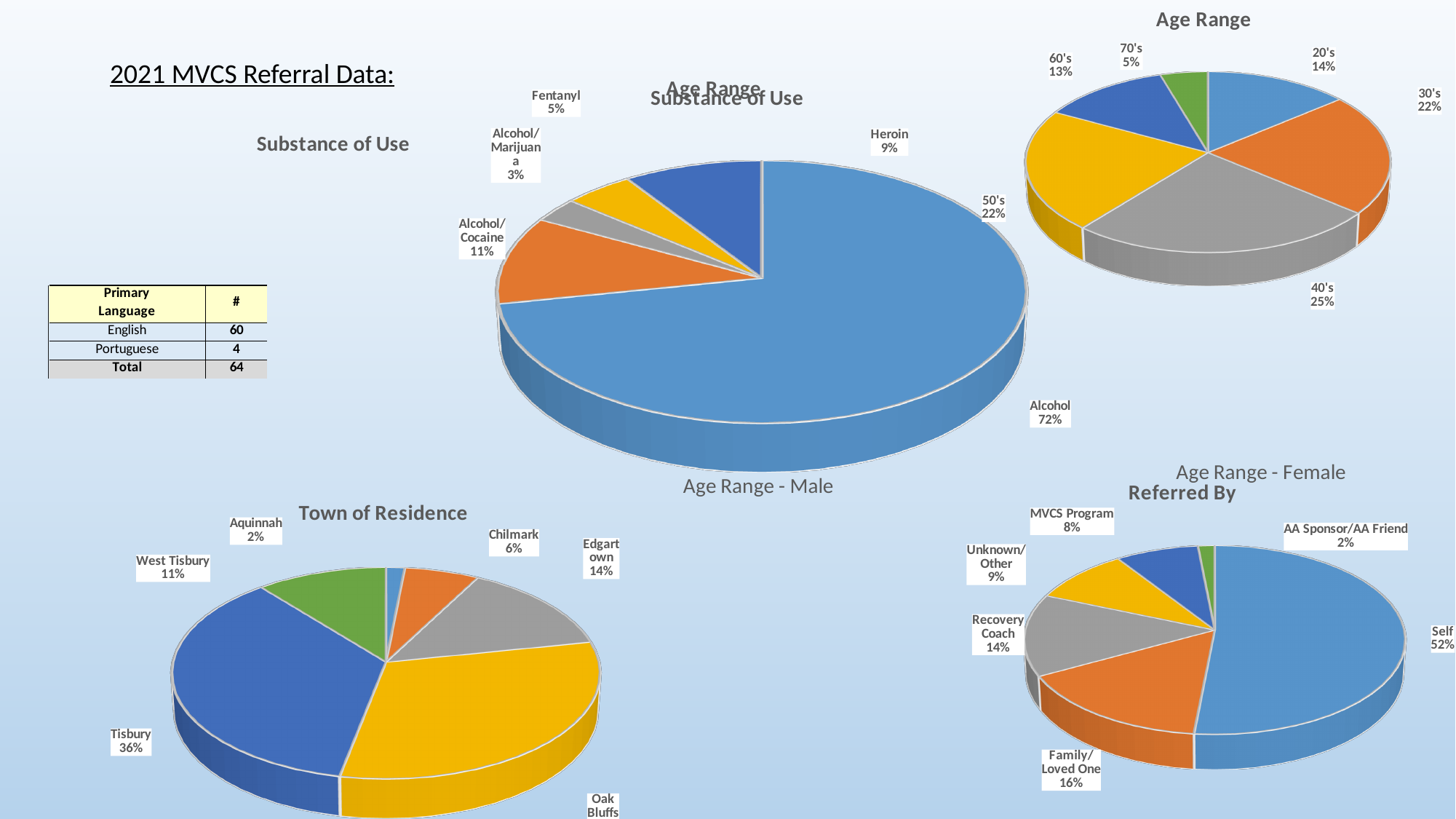
In the Substance of Use chart, which substance has the smallest share? Alcohol/Marijuana In the Substance of Use chart, what is the difference between the Alcohol/Cocaine and Heroin shares? 2% How many slices does the Substance of Use chart have? 5 How many age groups are shown in the Age Range chart? 6 What kind of chart is the Referred By chart? Pie chart In the Town of Residence chart, what percentage is Tisbury? 36% In the Age Range chart, which age group has the largest share? 40's In the Substance of Use chart, what percentage is Alcohol? 72% In the Town of Residence chart, which town has the smallest share? Aquinnah In the Referred By chart, what percentage of referrals were Self? 52% In the Age Range chart, which is larger, the 20's share or the 70's share? 20's In the Age Range chart, what percentage is the 60's group? 13%